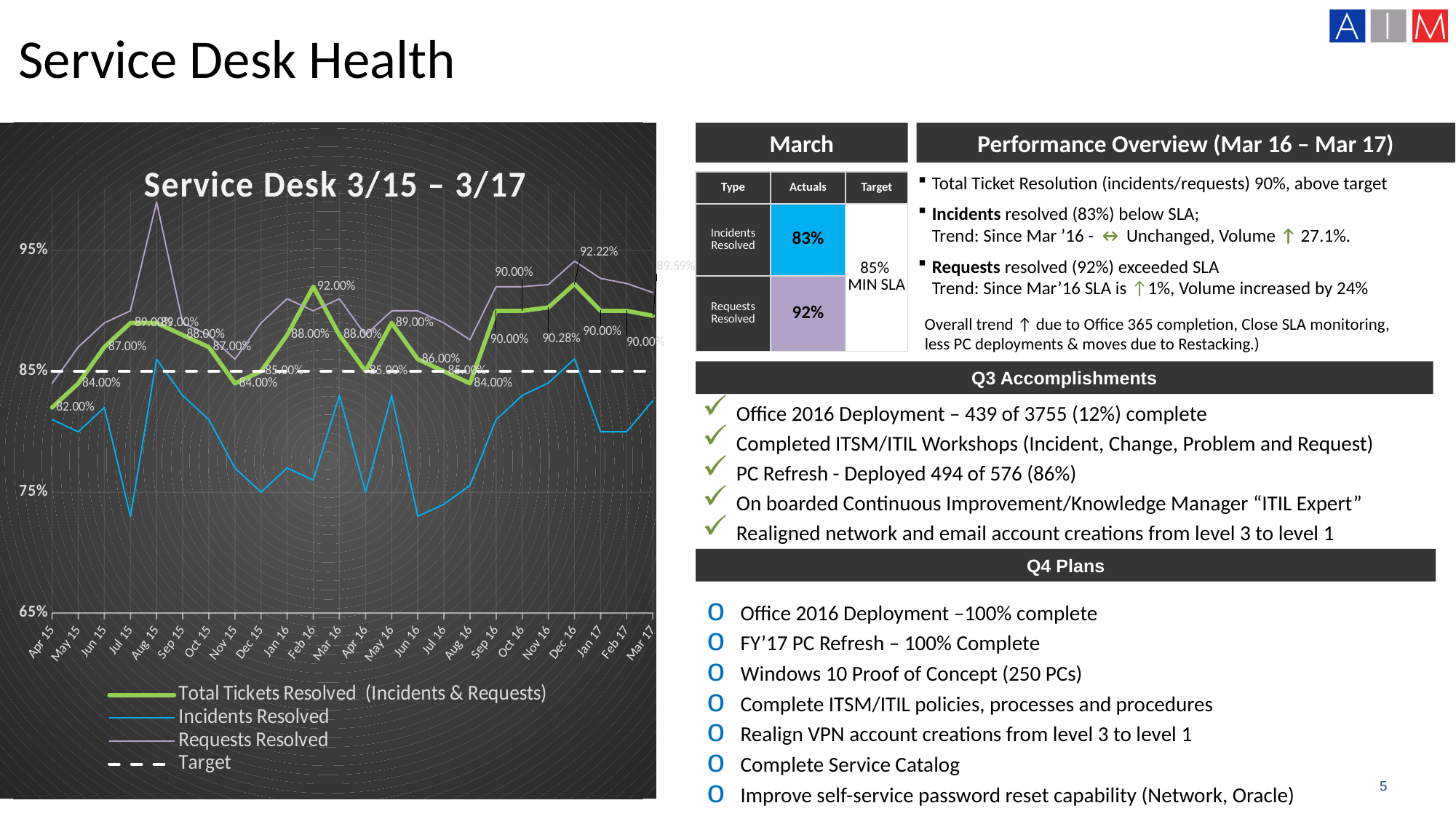
How many series does the chart legend list? 4 In Aug 15, which is higher: Requests Resolved or Incidents Resolved? Requests Resolved What kind of chart is shown on the slide? Line chart How many months are shown along the x axis of the chart? 24 Is the Incidents Resolved value for Jul 15 greater or less than 75%? less What is the Total Tickets Resolved value labelled for Apr 15? 82.00% What is the difference between the Total Tickets Resolved values for Dec 16 and Apr 15? 10.22 percentage points What is the title of the chart? Service Desk 3/15 – 3/17 What is the Total Tickets Resolved value labelled for Dec 16? 92.22% In which month does the Total Tickets Resolved line reach its highest labelled value? Dec 16 What is the Total Tickets Resolved value labelled for Feb 16? 92.00%